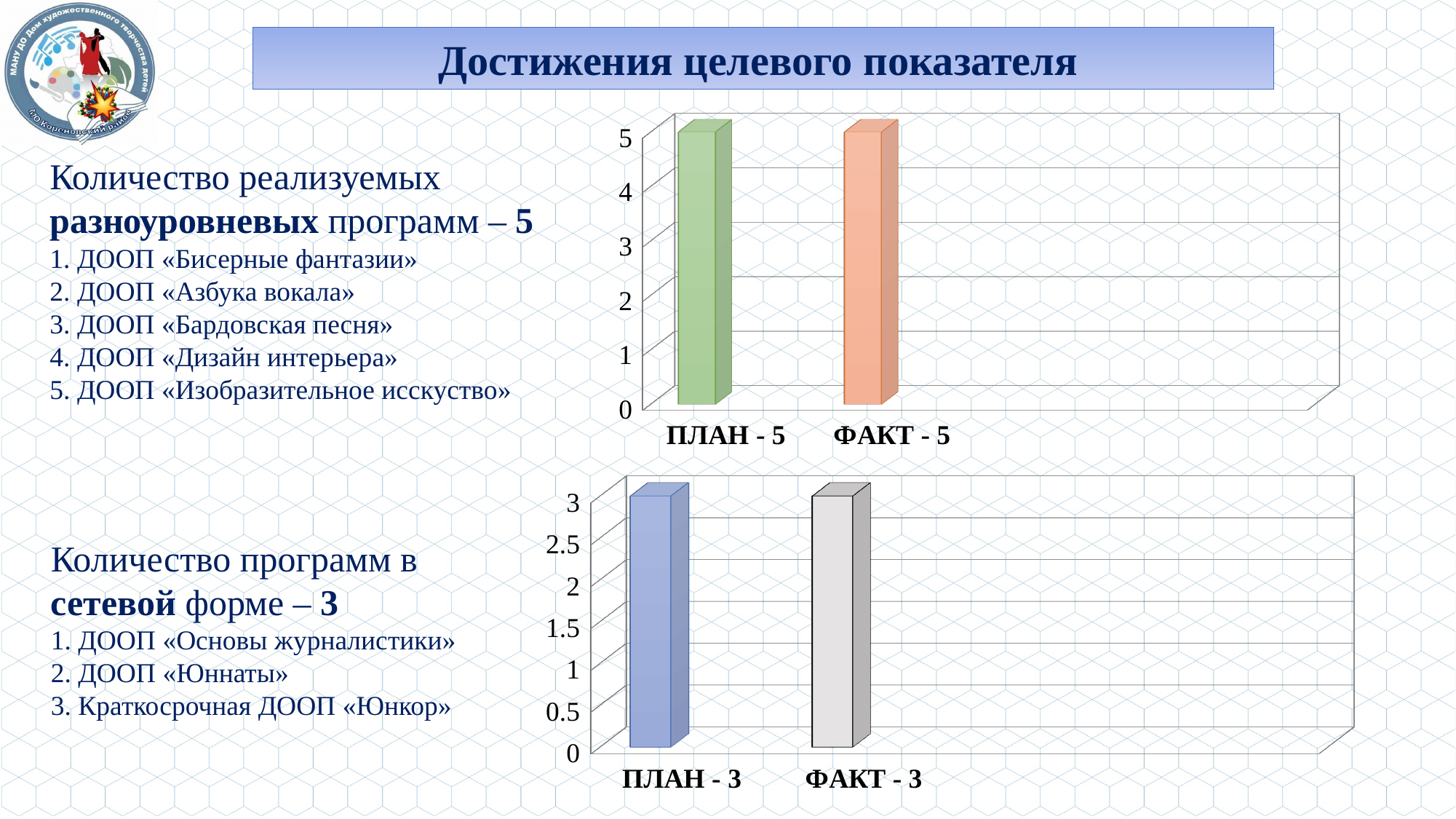
How many bars are shown in the bottom chart? 2 How many bars are shown in the top chart? 2 In the bottom chart, what is the value of the bar labelled ФАКТ - 3? 3 In the bottom chart, what is the difference between the ПЛАН - 3 bar and the ФАКТ - 3 bar? 0 In the top chart, what is the value of the bar labelled ФАКТ - 5? 5 In the top chart, what is the value of the bar labelled ПЛАН - 5? 5 In the top chart, what is the difference between the ПЛАН - 5 bar and the ФАКТ - 5 bar? 0 In the bottom chart, what is the value of the bar labelled ПЛАН - 3? 3 In the top chart, what colour is the ФАКТ - 5 bar? Orange In the bottom chart, is the value for ПЛАН - 3 greater or less than 2? greater What type of chart is the bottom chart? Bar chart What type of chart is the top chart? Bar chart